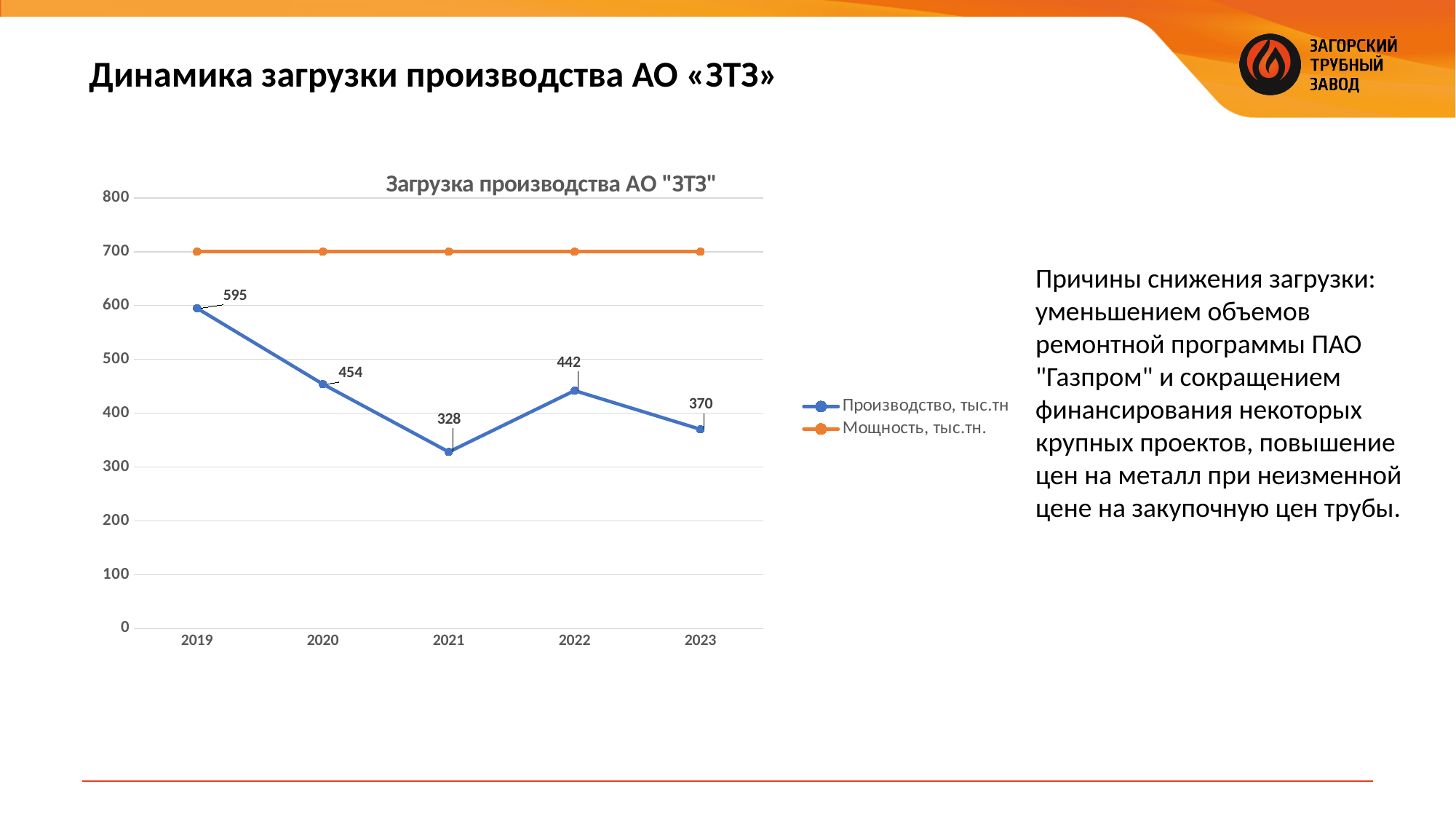
What is the value of Производство, тыс.тн in 2023? 370 Which is larger: Производство, тыс.тн in 2022 or in 2023? 2022 In which year is Производство, тыс.тн the highest? 2019 How many series does the legend list? 2 Is the value of Мощность, тыс.тн in 2021 greater or less than 600? greater What is the difference between Производство, тыс.тн in 2019 and in 2020? 141 What type of chart is shown on the slide? line chart What is the value of Производство, тыс.тн in 2021? 328 How many years are shown on the x axis? 5 What is the value of Производство, тыс.тн in 2019? 595 What is the title of the chart? Загрузка производства АО "ЗТЗ" In which year is Производство, тыс.тн the lowest? 2021